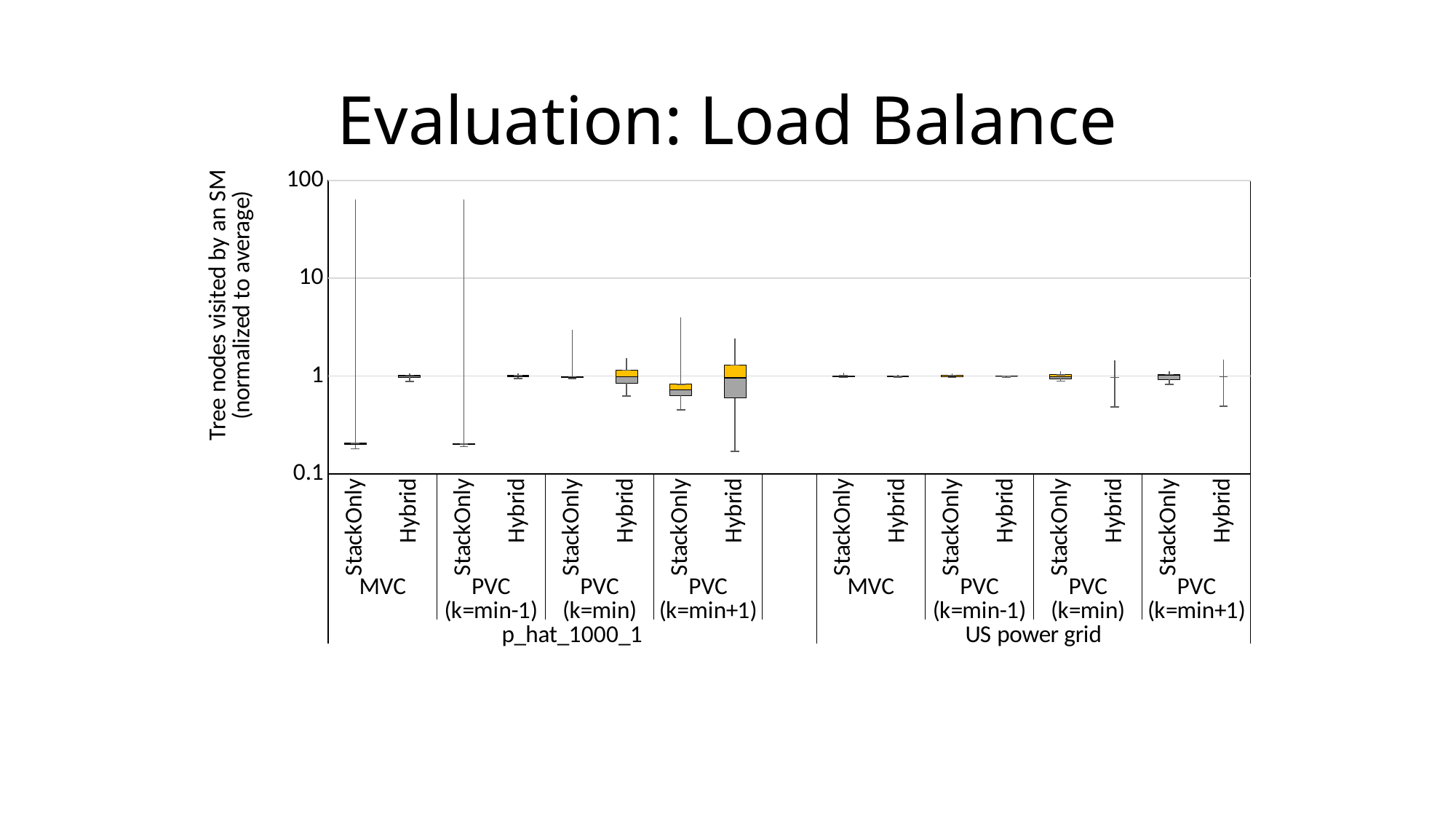
Is the bottom of the lower whisker for StackOnly under MVC on p_hat_1000_1 greater or less than 1? less Is the top of the upper whisker for StackOnly under PVC (k=min+1) on p_hat_1000_1 greater or less than 10? less What is the label of the y axis? Tree nodes visited by an SM (normalized to average) Under MVC on p_hat_1000_1, which has the larger whisker range, StackOnly or Hybrid? StackOnly What kind of chart is shown on the slide? Box-and-whisker plot How many box plots are shown in total on the chart? 16 Is the bottom of the lower whisker for Hybrid under PVC (k=min+1) on p_hat_1000_1 greater or less than 1? less How many datasets (graph groups) are shown along the x axis? 2 What is the title of the slide? Evaluation: Load Balance How many problem configurations (MVC and PVC variants) are shown for the p_hat_1000_1 dataset? 4 Which dataset shows the larger spread of values across its box plots, p_hat_1000_1 or US power grid? p_hat_1000_1